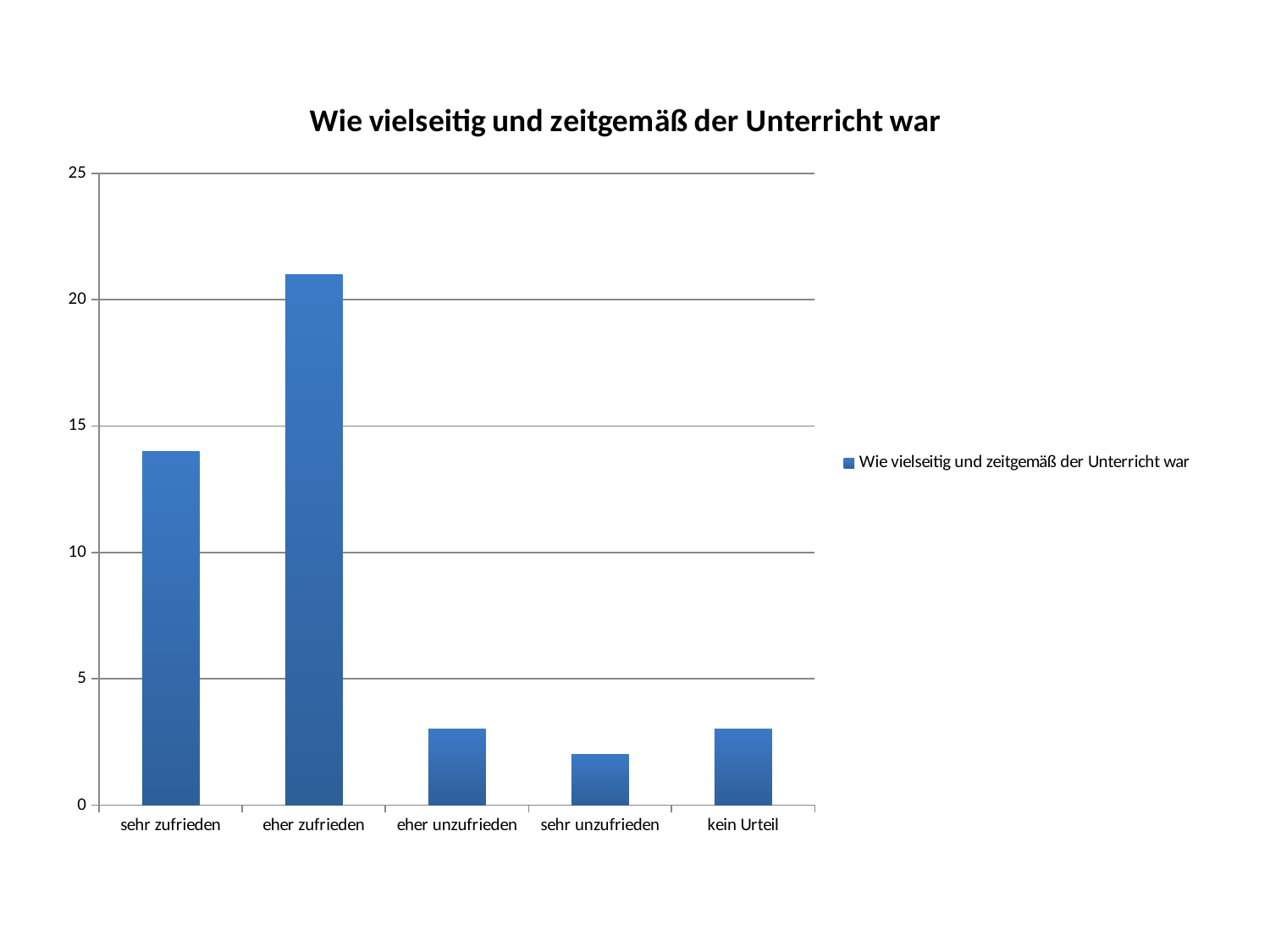
Is the value for sehr zufrieden greater or less than 15? less Which category has the lowest value? sehr unzufrieden Which category has the highest value? eher zufrieden What kind of chart is shown on the slide? bar chart Is the value for sehr zufrieden greater or less than 10? greater Is the value for eher zufrieden greater or less than 20? greater What is the title of the chart? Wie vielseitig und zeitgemäß der Unterricht war Which is larger, the value for sehr zufrieden or the value for eher zufrieden? eher zufrieden How many categories are shown on the x axis? 5 How many series does the legend list? 1 Which is larger, the value for sehr zufrieden or the value for kein Urteil? sehr zufrieden